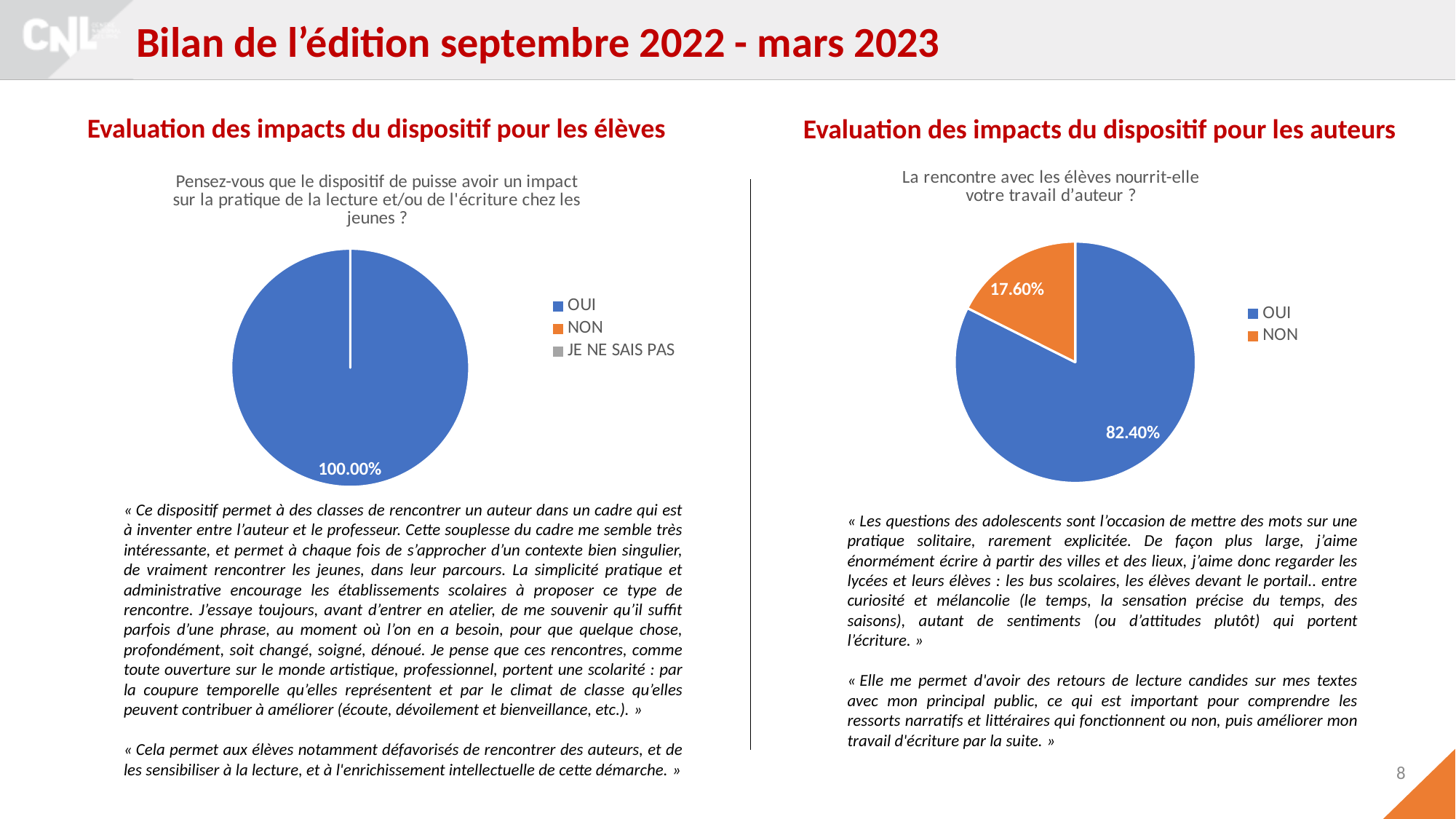
In the left chart ("Pensez-vous que le dispositif de puisse avoir un impact..."), what share is shown for OUI? 100.00% What type of chart is the right chart ("La rencontre avec les élèves nourrit-elle votre travail d'auteur ?")? Pie chart In the right chart ("La rencontre avec les élèves nourrit-elle votre travail d'auteur ?"), which slice is the smallest? NON How many entries does the legend of the right chart ("La rencontre avec les élèves nourrit-elle votre travail d'auteur ?") list? 2 In the right chart ("La rencontre avec les élèves nourrit-elle votre travail d'auteur ?"), what colour is the NON slice? Orange In the right chart ("La rencontre avec les élèves nourrit-elle votre travail d'auteur ?"), what share is shown for OUI? 82.40% In the right chart ("La rencontre avec les élèves nourrit-elle votre travail d'auteur ?"), what share is shown for NON? 17.60% How many entries does the legend of the left chart ("Pensez-vous que le dispositif de puisse avoir un impact...") list? 3 What type of chart is the left chart ("Pensez-vous que le dispositif de puisse avoir un impact...")? Pie chart In the right chart ("La rencontre avec les élèves nourrit-elle votre travail d'auteur ?"), which is larger, OUI or NON? OUI In the right chart ("La rencontre avec les élèves nourrit-elle votre travail d'auteur ?"), what is the difference in percentage points between OUI and NON? 64.80 In the right chart ("La rencontre avec les élèves nourrit-elle votre travail d'auteur ?"), which slice is the largest? OUI